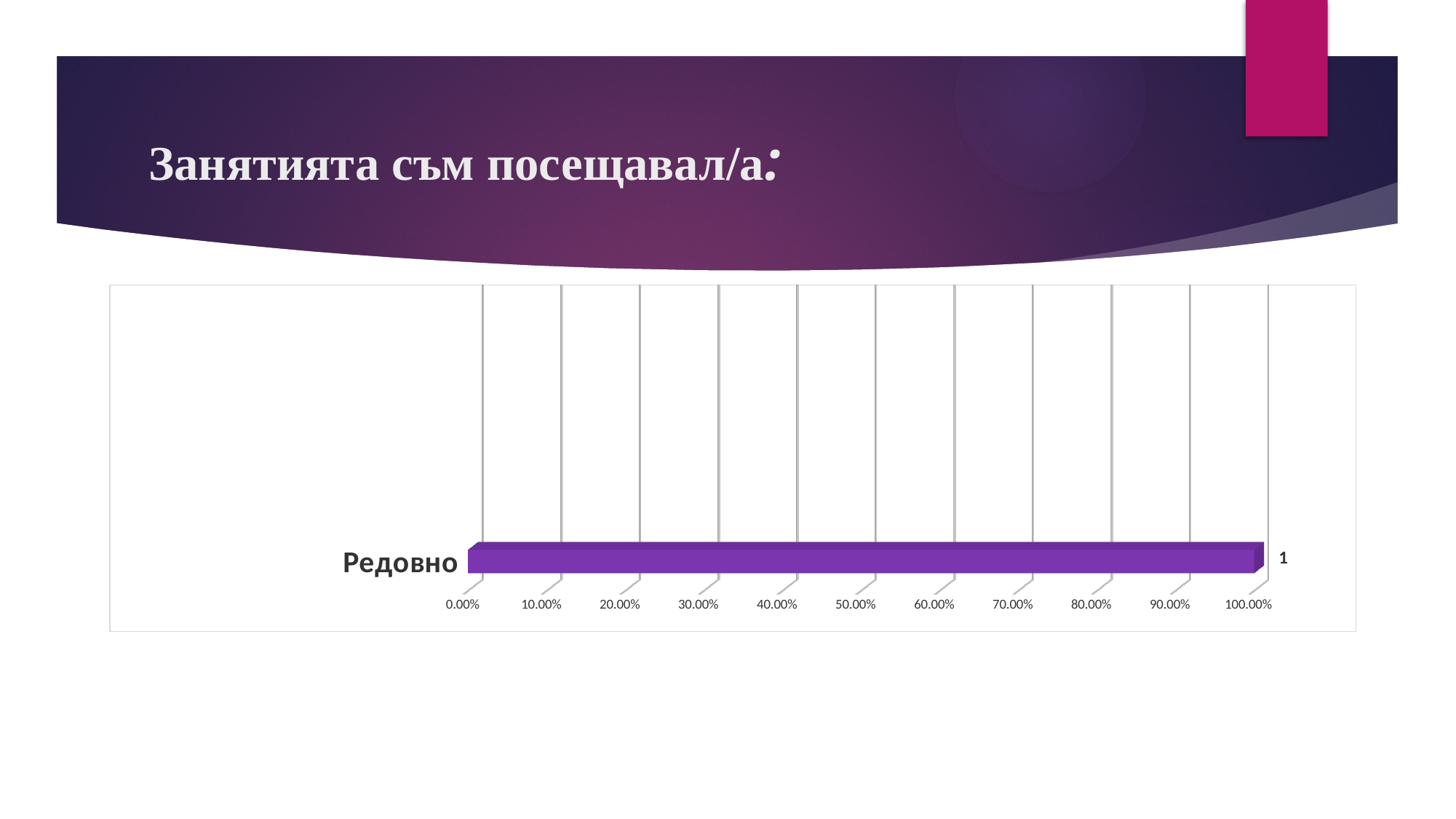
What is the label of the only category on the chart? Редовно How many categories does the chart show? 1 What is the data label shown next to the bar for Редовно? 1 What kind of chart is shown on the slide? bar chart Is the value for Редовно greater or less than 50.00%? greater What is the highest value shown on the horizontal axis? 100.00% Is the value for Редовно greater or less than 90.00%? greater